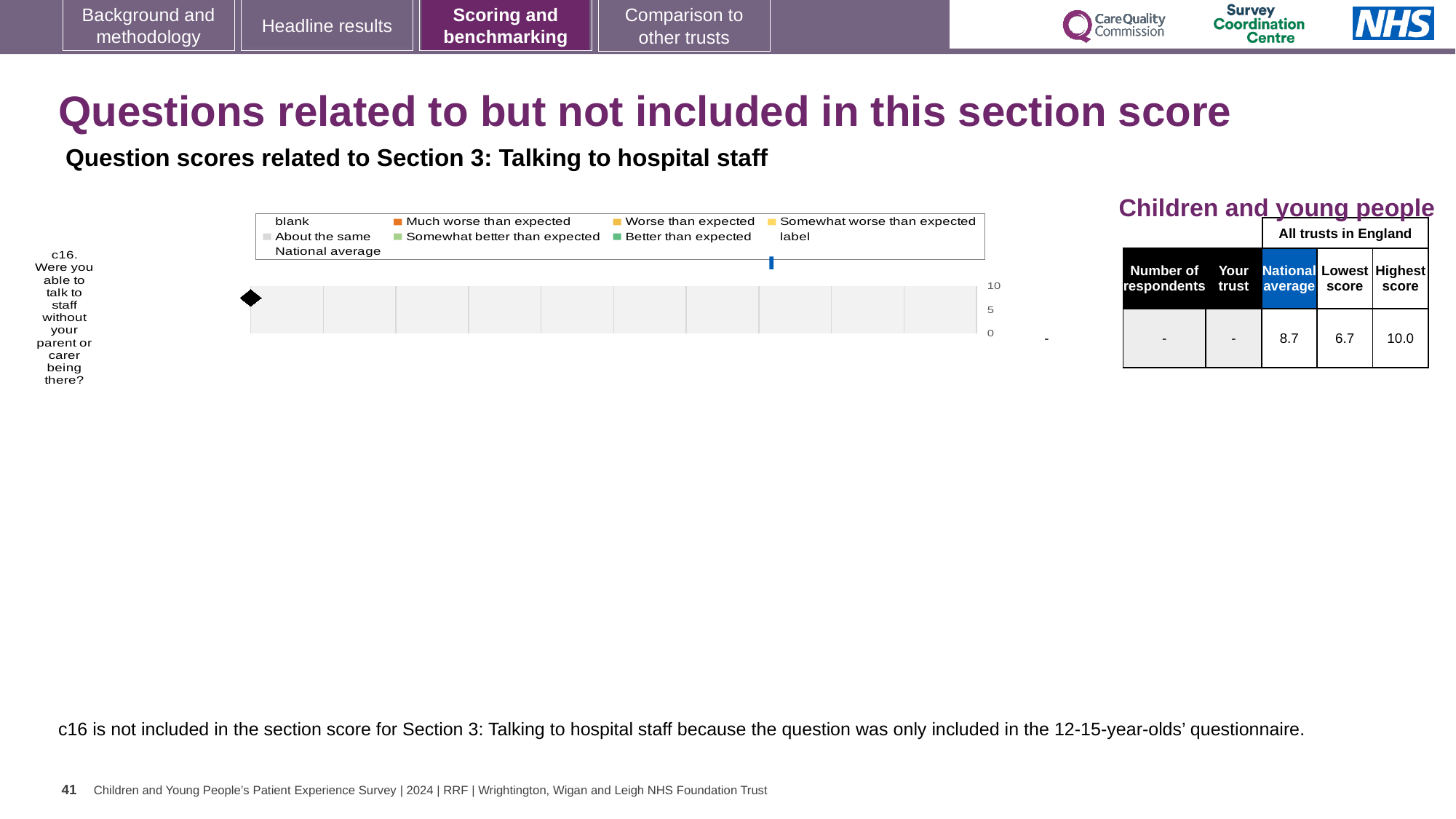
Is the national average score for c16 in the table greater or less than 5? greater In the table, what is the difference between the highest score and the lowest score for c16? 3.3 Which question is plotted on the chart? c16. Were you able to talk to staff without your parent or carer being there? What is the highest value shown on the chart's axis? 10 In the table, what is the highest score among all trusts in England for c16? 10.0 In the table, what is shown for 'Your trust' score for c16? - In the table, what is the lowest score among all trusts in England for c16? 6.7 In the table, which is larger for c16: the national average or the lowest score? national average How many questions (categories) are plotted on the chart? 1 What kind of chart is shown on the slide? bar chart In the table, what is the national average score for c16? 8.7